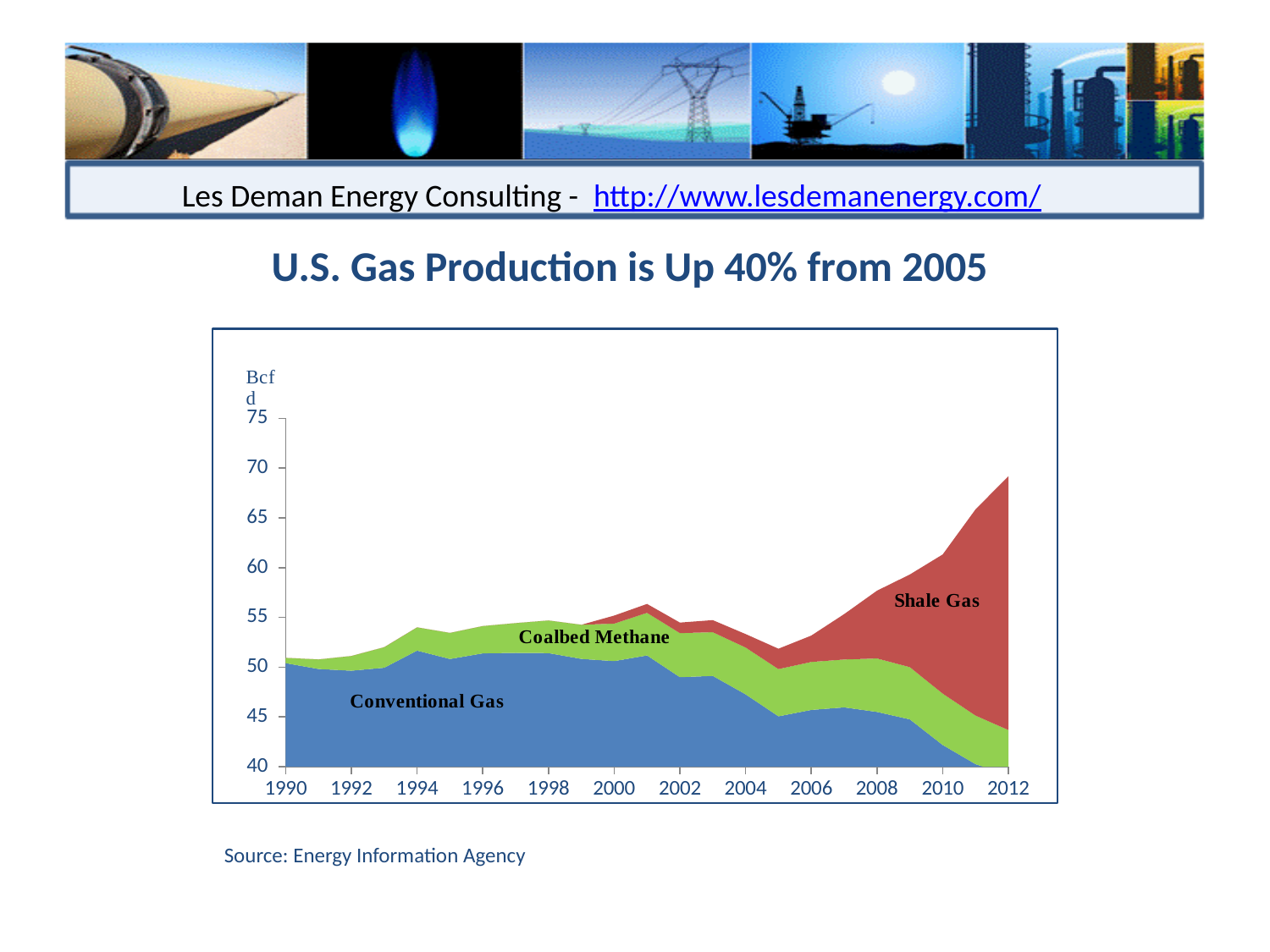
Does total gas production rise or fall between 2005 and 2012? rise In which year shown is total gas production highest? 2012 Is the total gas production in 2005 greater or less than 55 Bcfd? less Which three series are labeled in the chart? Conventional Gas, Coalbed Methane, Shale Gas Which year has the higher total gas production, 1990 or 2012? 2012 What kind of chart is shown on the slide? Stacked area chart Is the total gas production in 2012 greater or less than 65 Bcfd? greater Does the Conventional Gas series rise or fall between 2000 and 2012? fall What is the title of the chart? U.S. Gas Production is Up 40% from 2005 Is the Conventional Gas value in 2012 greater or less than 45 Bcfd? less How many gas production series are labeled in the chart? 3